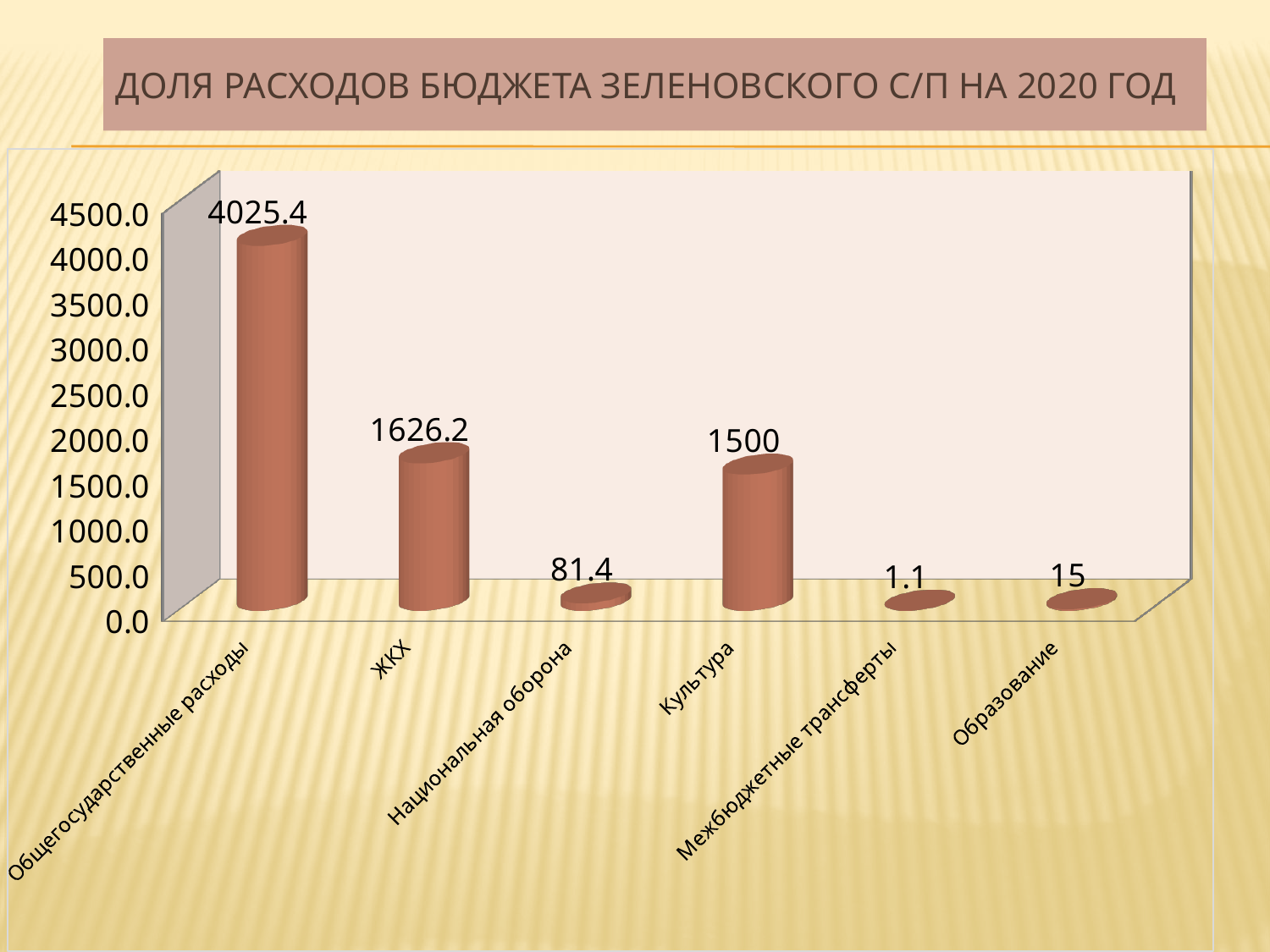
How many categories are shown on the x axis? 6 What is the value for ЖКХ? 1626.2 What is the value for Образование? 15 What is the value for Национальная оборона? 81.4 Which category has the highest value? Общегосударственные расходы What kind of chart is shown on the slide? Bar chart What is the value for Общегосударственные расходы? 4025.4 What is the value for Культура? 1500 What is the difference between the values for ЖКХ and Культура? 126.2 Which is larger, the value for Образование or the value for Национальная оборона? Национальная оборона Which category has the lowest value? Межбюджетные трансферты What is the title of the chart on the slide? ДОЛЯ РАСХОДОВ БЮДЖЕТА ЗЕЛЕНОВСКОГО С/П НА 2020 ГОД